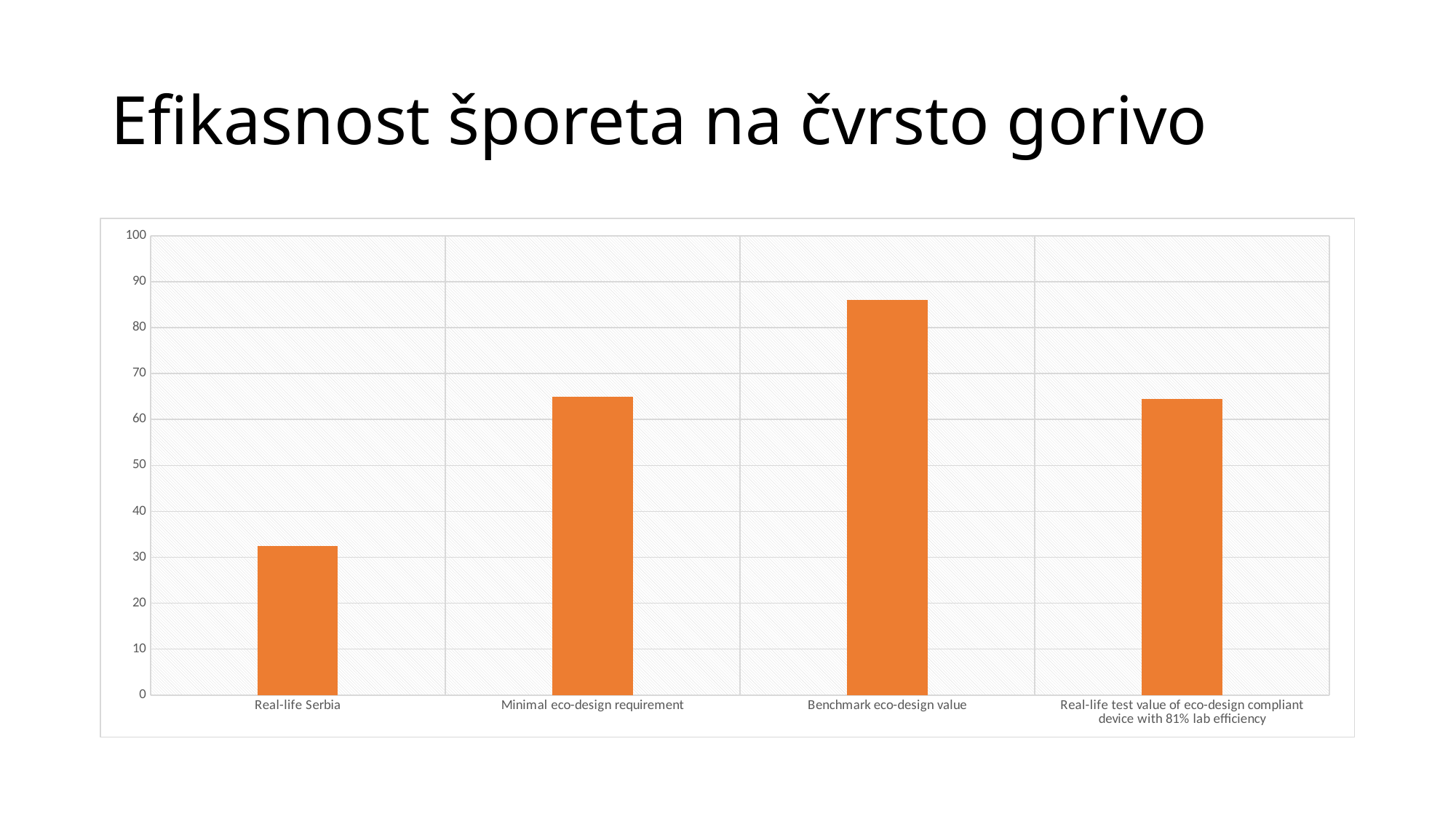
Is the value for Benchmark eco-design value greater or less than 80? greater Which is larger, the value for Real-life Serbia or the value for Real-life test value of eco-design compliant device with 81% lab efficiency? Real-life test value of eco-design compliant device with 81% lab efficiency Is the value for Real-life test value of eco-design compliant device with 81% lab efficiency greater or less than 70? less Which is larger, the value for Benchmark eco-design value or the value for Minimal eco-design requirement? Benchmark eco-design value Is the value for Minimal eco-design requirement greater or less than 60? greater How many categories are plotted on the chart? 4 What kind of chart is shown on the slide? bar chart Which category has the lowest bar? Real-life Serbia Which category has the highest bar? Benchmark eco-design value What is the title of the slide containing the chart? Efikasnost šporeta na čvrsto gorivo